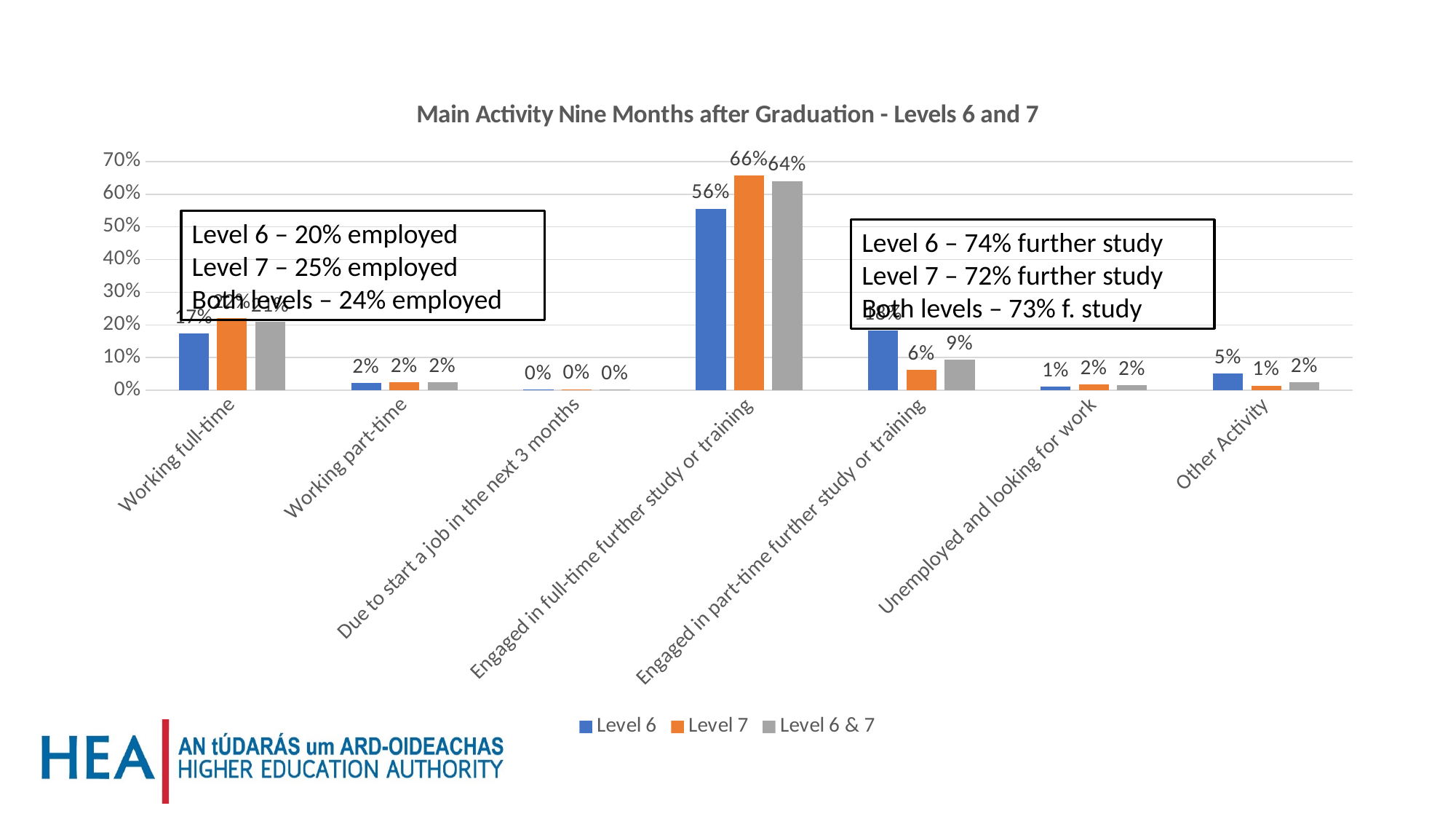
What is the value for Level 6 in the 'Other Activity' category? 5% Is the Level 6 value for 'Working full-time' greater or less than 20%? less What is the value for Level 7 in the 'Engaged in part-time further study or training' category? 6% How many series does the legend list? 3 Which category has the highest value for Level 7? Engaged in full-time further study or training What is the value for Level 6 in the 'Engaged in full-time further study or training' category? 56% How many categories are shown on the x axis? 7 What is the value for Level 6 & 7 in the 'Engaged in part-time further study or training' category? 9% In the 'Other Activity' category, which is larger: Level 6 or Level 7? Level 6 What type of chart is shown on the slide? bar chart What is the difference between the Level 7 and Level 6 values for 'Engaged in full-time further study or training'? 10% What is the value for Level 7 in the 'Engaged in full-time further study or training' category? 66%